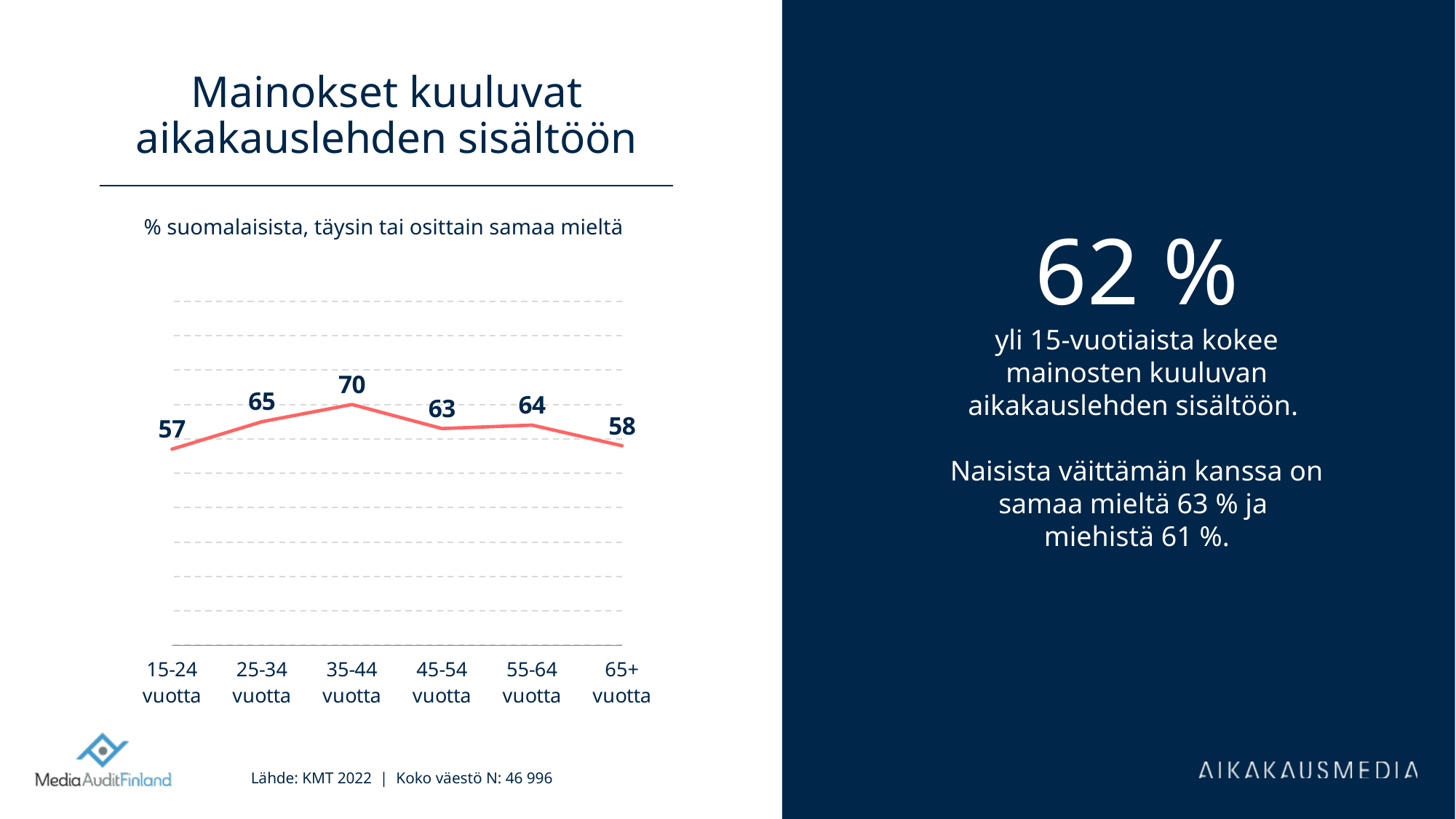
What is the value for the 15-24 vuotta age group? 57 Which age group has the lowest value? 15-24 vuotta Which is larger, the value for 55-64 vuotta or the value for 65+ vuotta? 55-64 vuotta How many age groups are plotted on the chart? 6 What is the value for the 35-44 vuotta age group? 70 What is the value for the 55-64 vuotta age group? 64 What is the difference between the values for 25-34 vuotta and 45-54 vuotta? 2 What is the subtitle shown above the chart? % suomalaisista, täysin tai osittain samaa mieltä What is the value for the 65+ vuotta age group? 58 What is the difference between the values for 35-44 vuotta and 15-24 vuotta? 13 Which age group has the highest value? 35-44 vuotta What kind of chart is shown on the slide? line chart